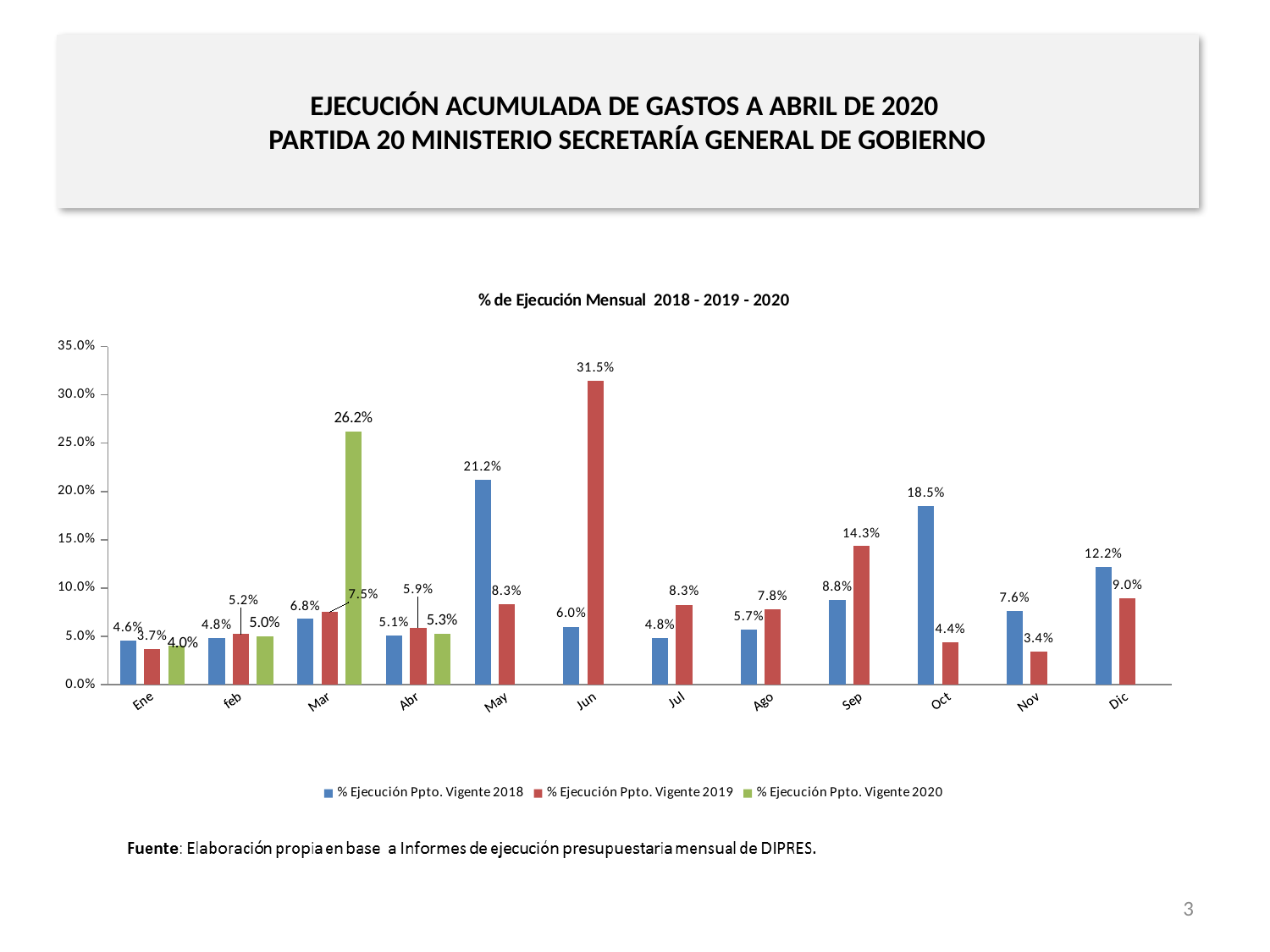
In which month is the % Ejecución Ppto. Vigente 2018 series highest? May What is the difference between the 2019 and 2018 values in Sep? 5.5% What is the value for % Ejecución Ppto. Vigente 2019 in Jun? 31.5% What is the value for % Ejecución Ppto. Vigente 2018 in Oct? 18.5% Which is larger in Dic: the 2018 value or the 2019 value? 2018 (12.2%) Is the value for % Ejecución Ppto. Vigente 2019 in Jun greater or less than 30.0%? greater What is the title of the chart? % de Ejecución Mensual 2018 - 2019 - 2020 How many series does the legend list? 3 What is the value for % Ejecución Ppto. Vigente 2020 in Mar? 26.2% What kind of chart is shown on the slide? Bar chart How many months are shown on the x axis? 12 In which month is the % Ejecución Ppto. Vigente 2019 series lowest? Nov